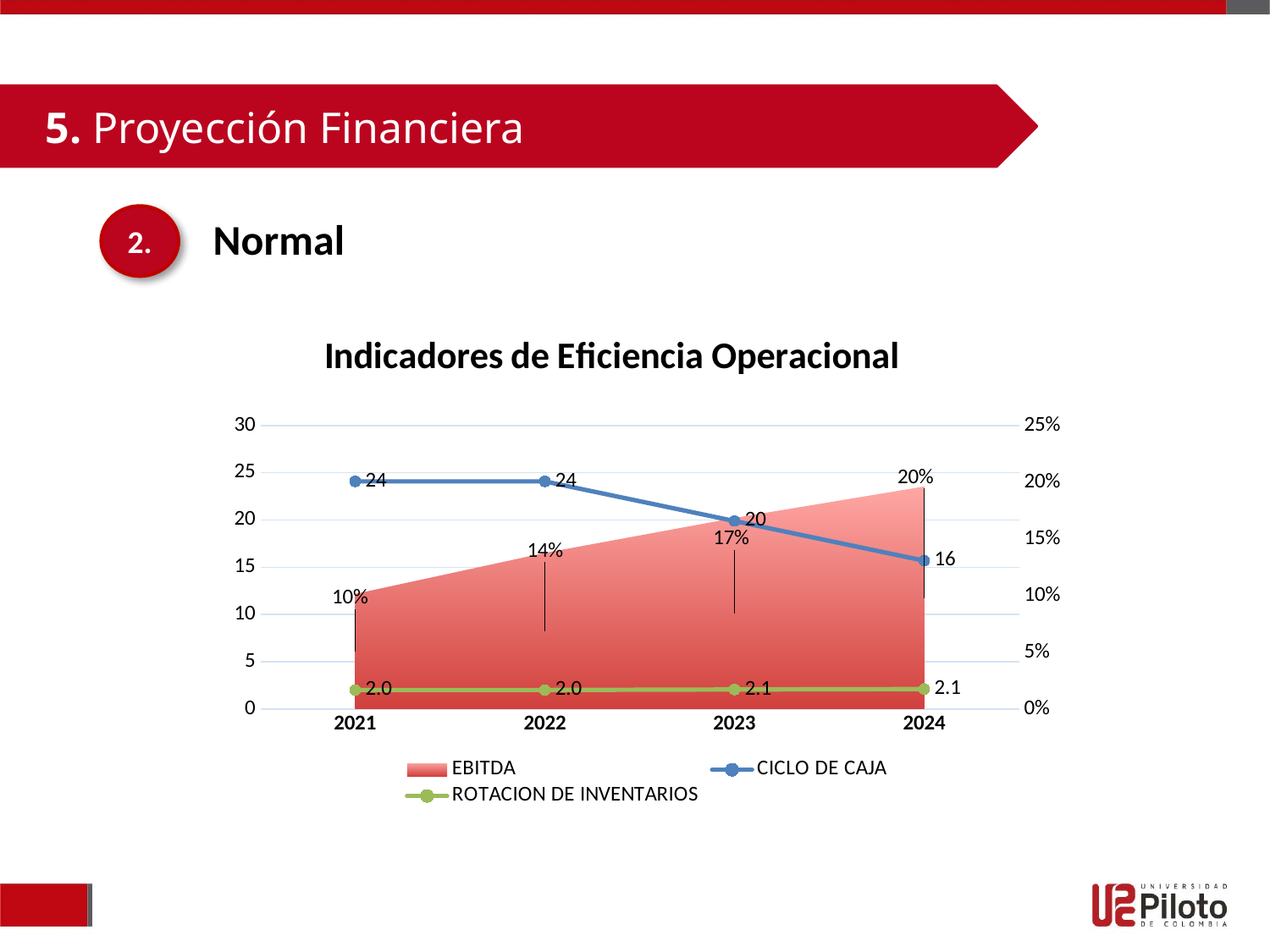
In which year is EBITDA highest? 2024 What is the difference between the CICLO DE CAJA values for 2022 and 2023? 4 What is the title of the chart? Indicadores de Eficiencia Operacional What is the EBITDA value for 2022? 14% Does CICLO DE CAJA rise or fall from 2022 to 2024? fall Which is larger, the CICLO DE CAJA value for 2021 or for 2024? 2021 What is the CICLO DE CAJA value for 2024? 16 In which year is CICLO DE CAJA lowest? 2024 What is the ROTACION DE INVENTARIOS value for 2023? 2.1 What is the difference between the EBITDA values for 2024 and 2021? 10% How many years are shown on the x axis? 4 How many series does the legend list? 3